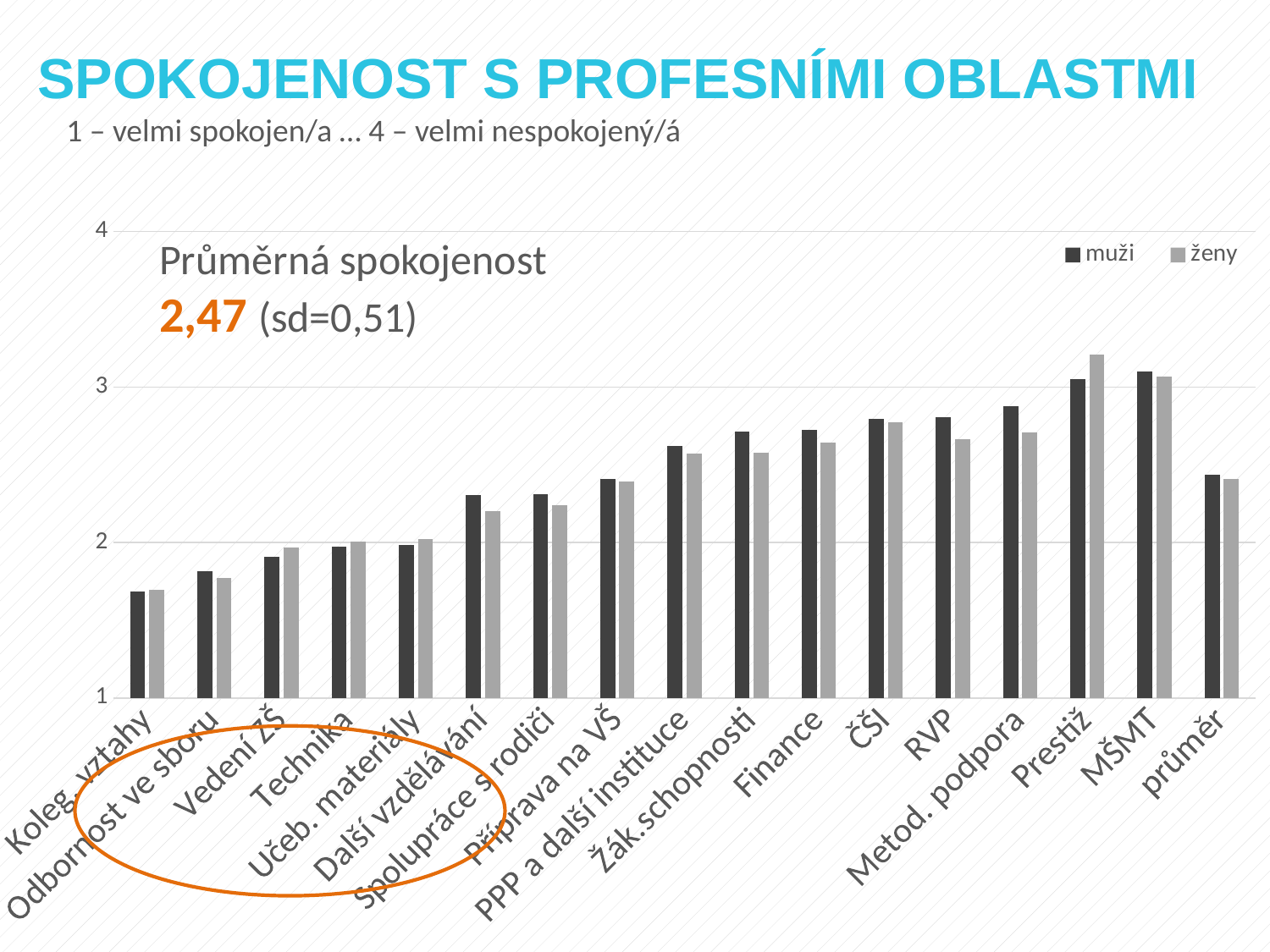
Is the muži value for MŠMT greater or less than 3? greater Is the muži value for Další vzdělávání greater or less than 2? greater How many series does the legend list? 2 Which category has the highest value for the ženy series? Prestiž Is the muži value for Koleg. vztahy greater or less than 2? less How many categories are shown on the x axis? 17 What kind of chart is shown on the slide? bar chart What average satisfaction value (Průměrná spokojenost) is printed on the chart? 2,47 For Metod. podpora, which series has the larger value, muži or ženy? muži For Prestiž, which series has the larger value, muži or ženy? ženy Which category has the lowest value for the ženy series? Koleg. vztahy